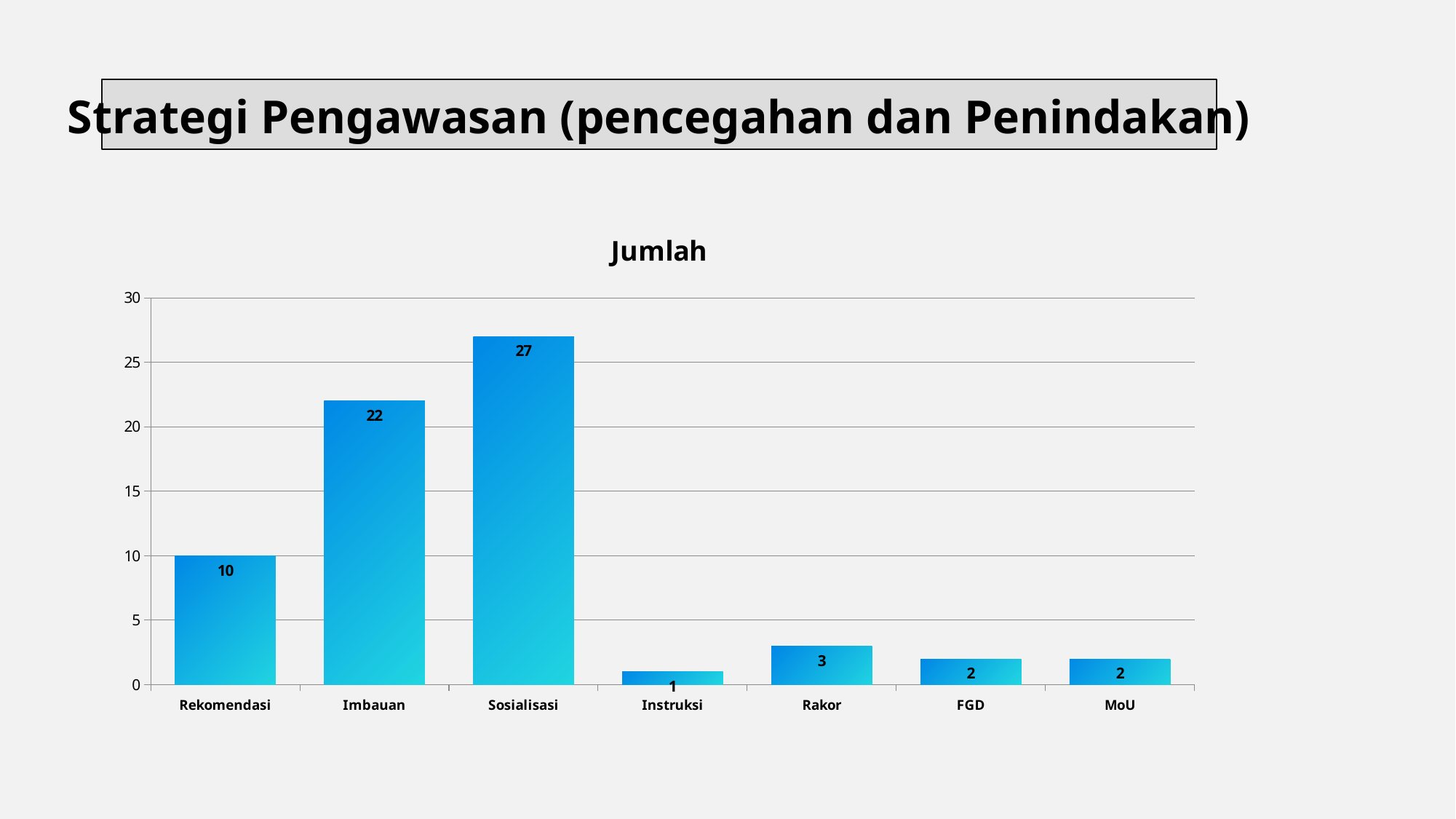
What is the title of the chart? Jumlah Is the value for Imbauan greater or less than 20? greater What is the value for Rakor? 3 What is the difference between the values for Sosialisasi and Imbauan? 5 What is the value for Rekomendasi? 10 How many categories are shown on the x axis? 7 Which is larger, the value for Imbauan or the value for Rekomendasi? Imbauan What kind of chart is shown on the slide? bar chart What is the value for Sosialisasi? 27 What is the difference between the values for Rekomendasi and FGD? 8 Which category has the highest value? Sosialisasi Which category has the lowest value? Instruksi